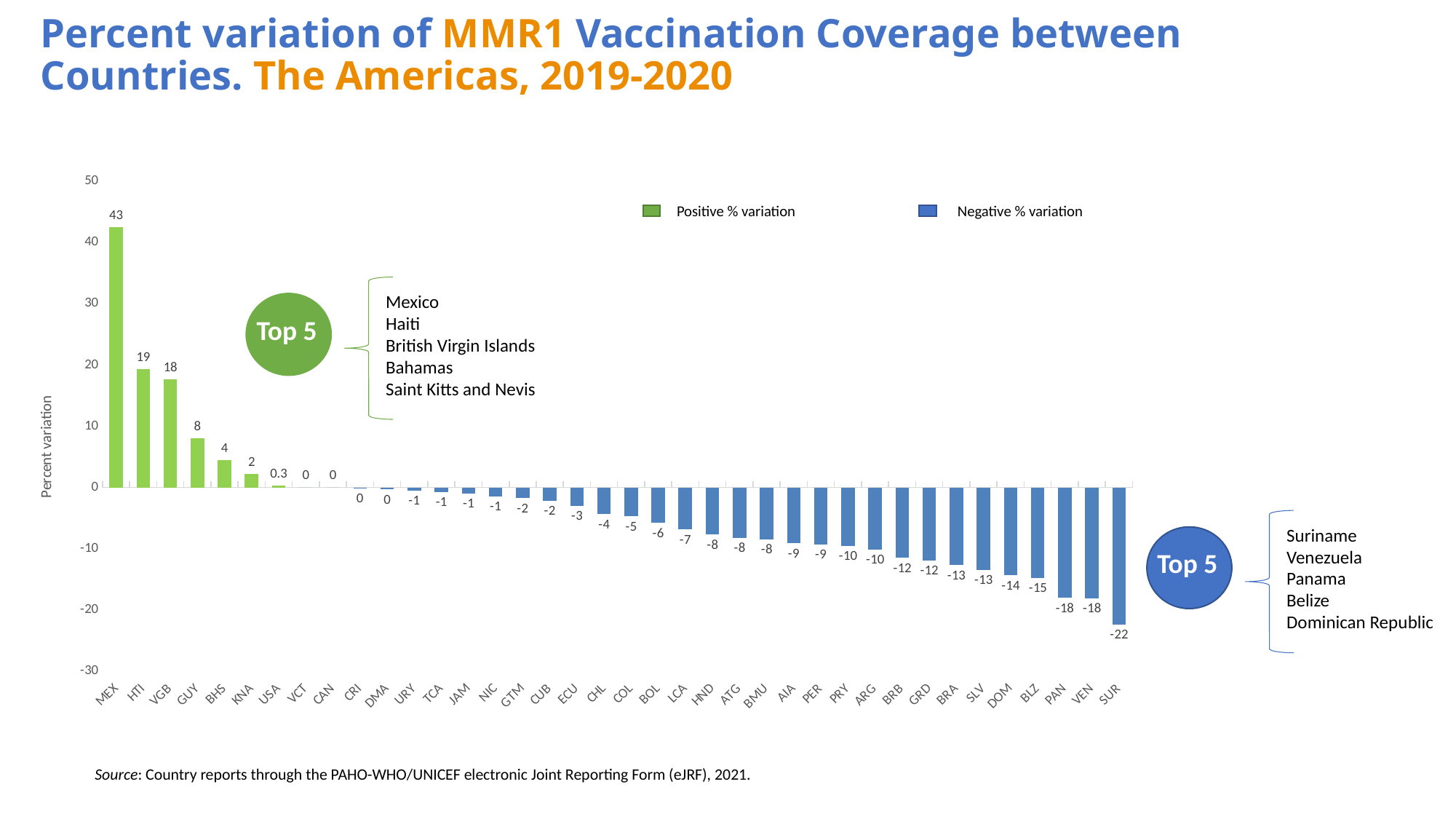
What kind of chart is shown on the slide? Bar chart What is the percent variation for MEX? 43 What is the percent variation for GUY? 8 What colour are the bars for negative % variation? Blue Which country has the highest percent variation? MEX What is the percent variation for BLZ? -15 What is the percent variation for SUR? -22 Which has a larger percent variation, BHS or KNA? BHS Which country has the lowest percent variation? SUR How many countries are shown on the x axis? 38 What is the difference between the percent variation for HTI and VGB? 1 How many series does the legend list? 2